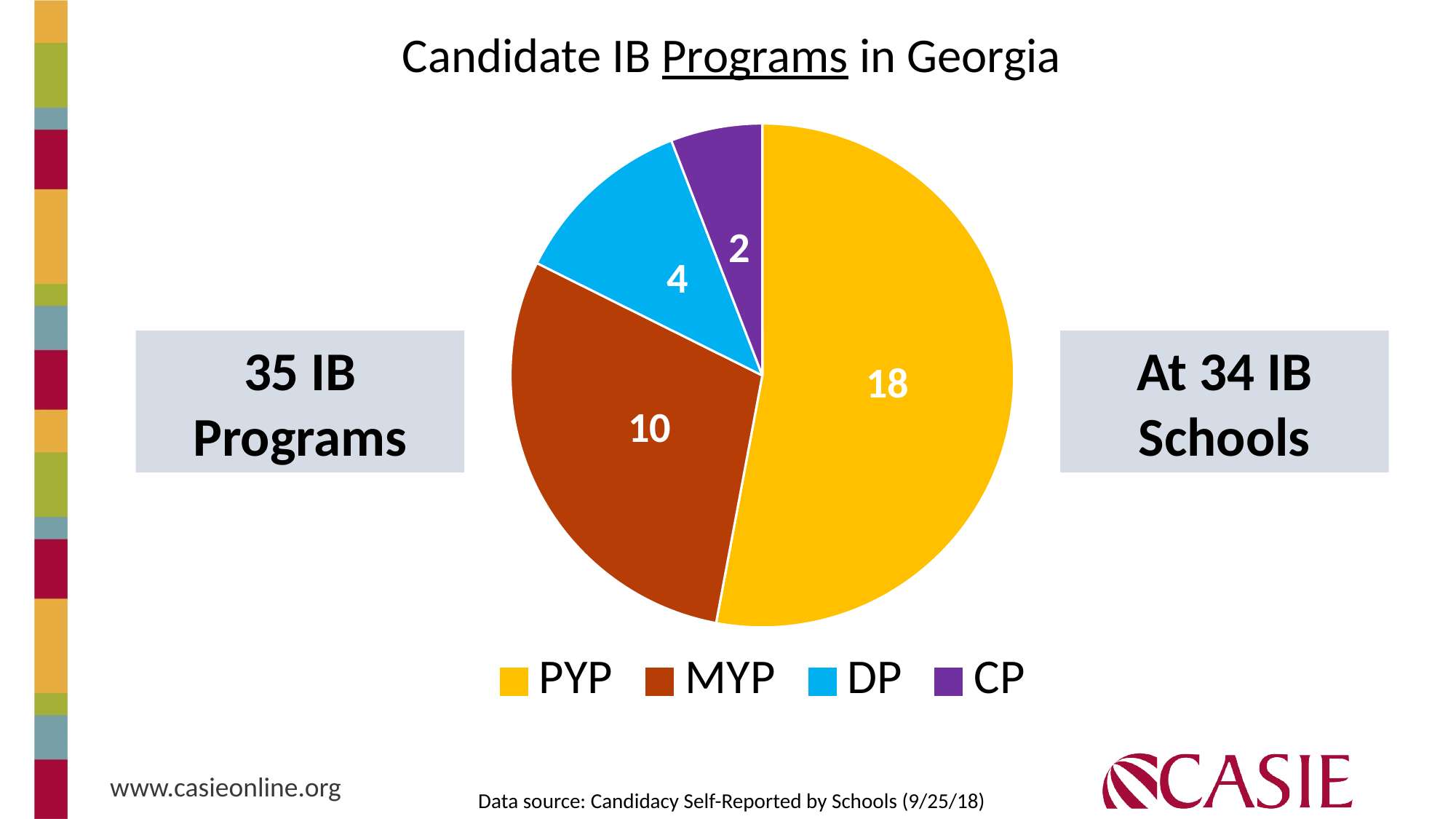
How many candidate PYP programs are shown in the pie chart? 18 How many categories does the pie chart have? 4 What is the difference between the PYP and MYP values? 8 What is the value for CP in the pie chart? 2 What is the value for MYP in the pie chart? 10 Which program has the smallest slice of the pie chart? CP Which program has the largest slice of the pie chart? PYP What is the value for DP in the pie chart? 4 What is the title of the chart? Candidate IB Programs in Georgia What is the total of all slices in the pie chart? 34 What type of chart is shown on the slide? pie chart Which is larger, the value for DP or the value for CP? DP